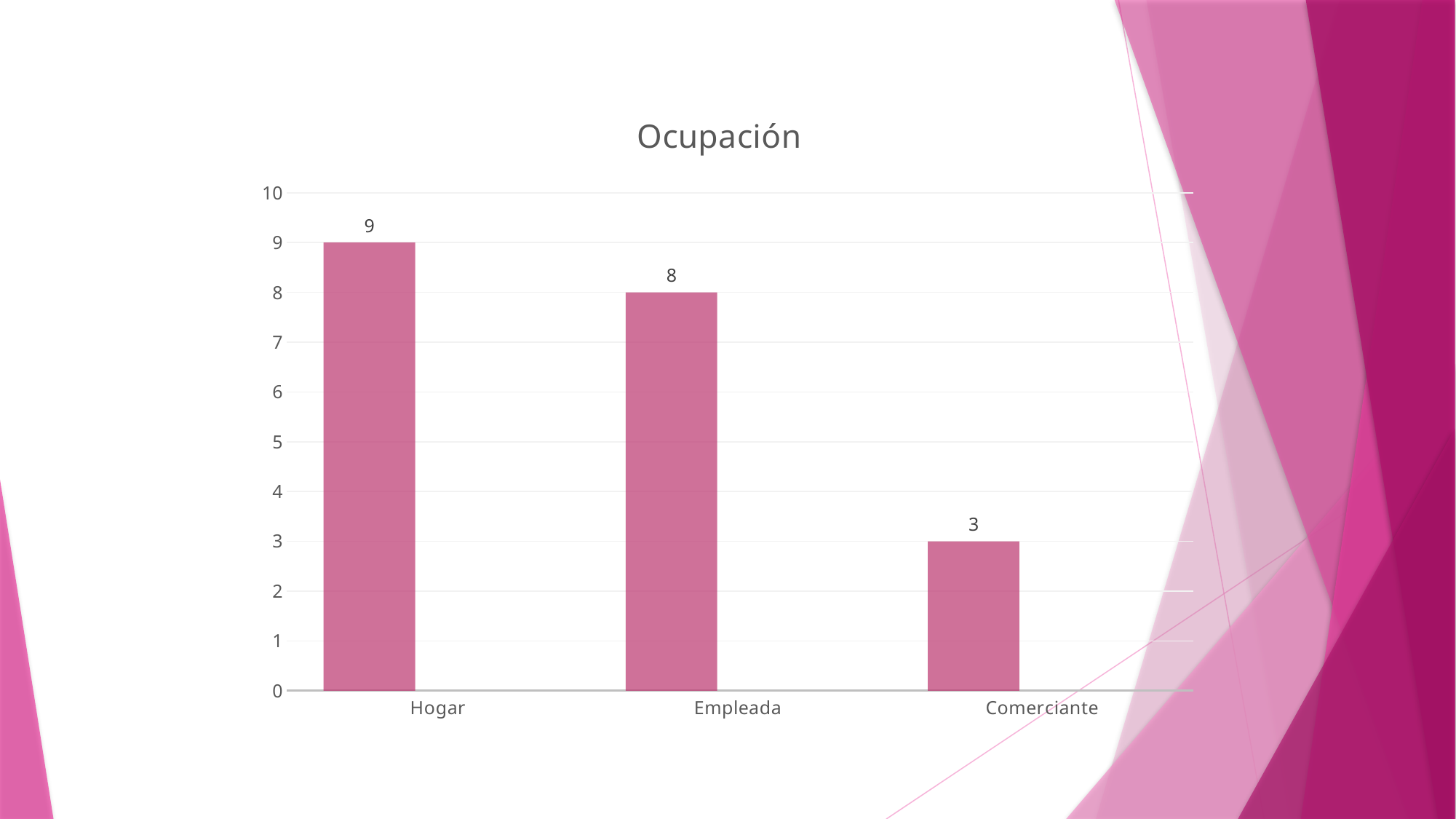
Which category has the highest value? Hogar What kind of chart is shown on the slide? bar chart What is the value for Comerciante? 3 Which is larger, the value for Empleada or the value for Comerciante? Empleada Which category has the lowest value? Comerciante Is the value for Comerciante greater or less than 5? less What is the difference between the values for Empleada and Comerciante? 5 What is the value for Empleada? 8 How many categories are shown on the x axis? 3 What is the title of the chart? Ocupación What is the difference between the values for Hogar and Comerciante? 6 What is the value for Hogar? 9